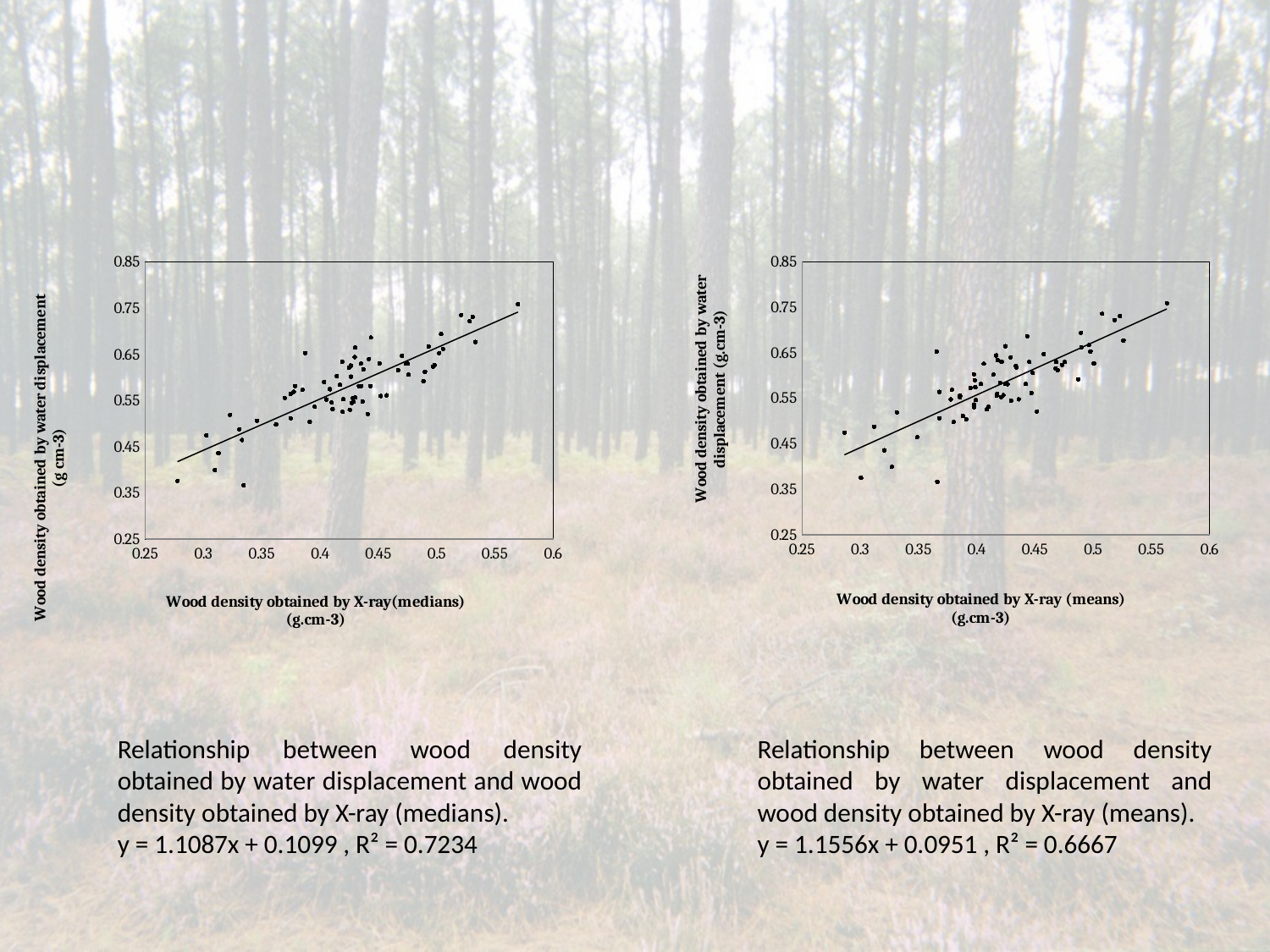
On the left chart, is the water-displacement density of the rightmost point greater or less than 0.65? greater What kind of chart is the right chart (wood density by X-ray means)? scatter chart On the right chart, do the plotted values rise or fall as the X-ray mean density increases along the x axis? rise On the left chart, is the lowest plotted water-displacement density greater or less than 0.45? less What kind of chart is the left chart (wood density by X-ray medians)? scatter chart On the right chart, is the water-displacement density of the rightmost point greater or less than 0.65? greater On the left chart, do the plotted values rise or fall as the X-ray median density increases along the x axis? rise What is the x-axis label of the left chart? Wood density obtained by X-ray(medians) (g.cm-3) What is the x-axis label of the right chart? Wood density obtained by X-ray (means) (g.cm-3)